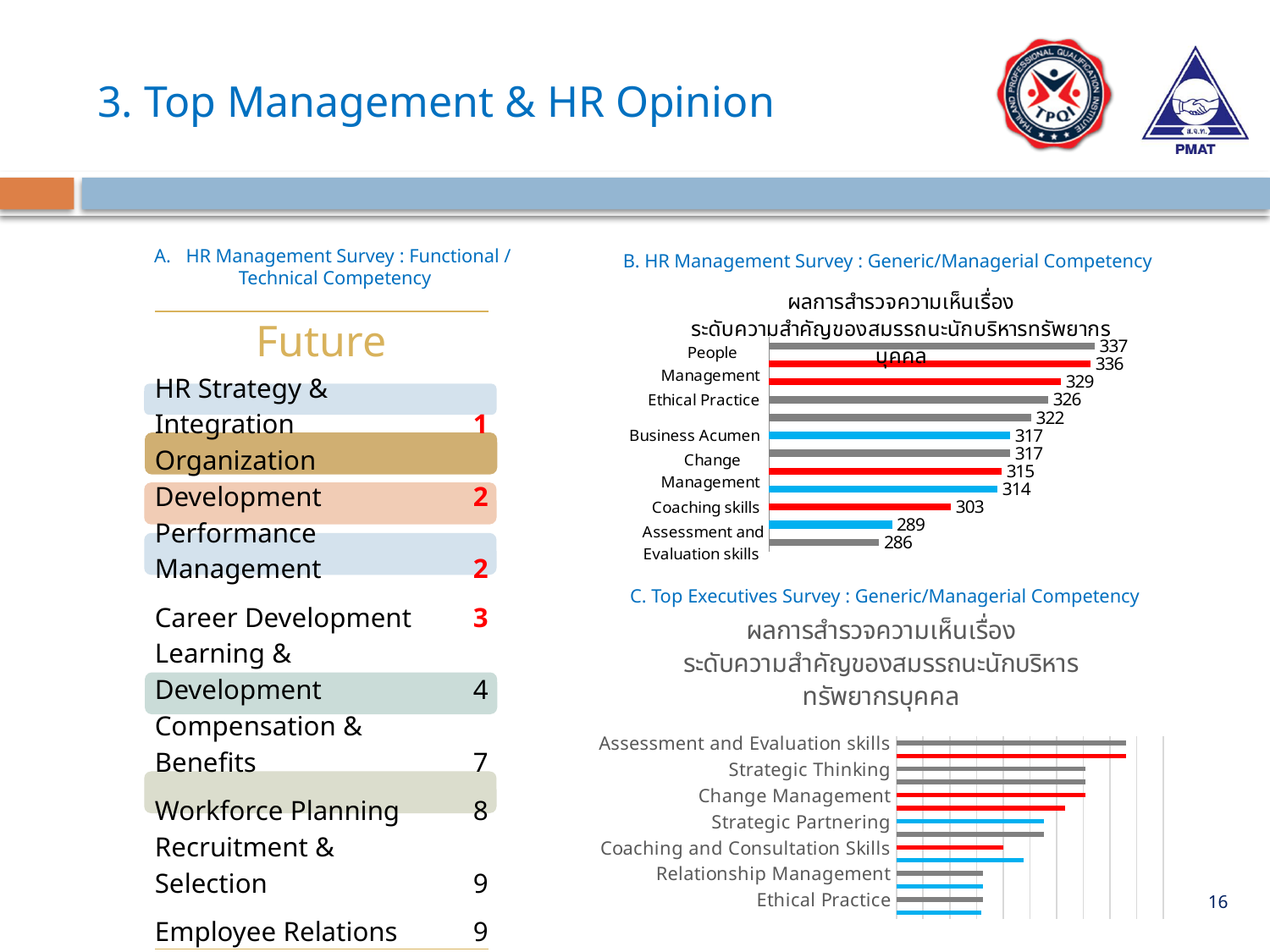
In chart B (HR Management Survey : Generic/Managerial Competency), what is the highest value labelled on any bar? 337 In chart B (HR Management Survey : Generic/Managerial Competency), what is the lowest value labelled on any bar? 286 How many category labels are shown on the vertical axis of chart B (HR Management Survey : Generic/Managerial Competency)? 6 In chart B (HR Management Survey : Generic/Managerial Competency), what is the difference between the highest labelled value (337) and the lowest labelled value (286)? 51 Which category label appears at the top of chart B (HR Management Survey : Generic/Managerial Competency)? People Management In chart C (Top Executives Survey : Generic/Managerial Competency), which has longer bars: Strategic Thinking or Relationship Management? Strategic Thinking How many categories are listed in chart C (Top Executives Survey : Generic/Managerial Competency)? 7 Which category is listed last (at the bottom) in chart C (Top Executives Survey : Generic/Managerial Competency)? Ethical Practice What kind of chart is chart B (HR Management Survey : Generic/Managerial Competency)? bar chart How many data labels are printed on the bars in chart B (HR Management Survey : Generic/Managerial Competency)? 12 What kind of chart is chart C (Top Executives Survey : Generic/Managerial Competency)? bar chart